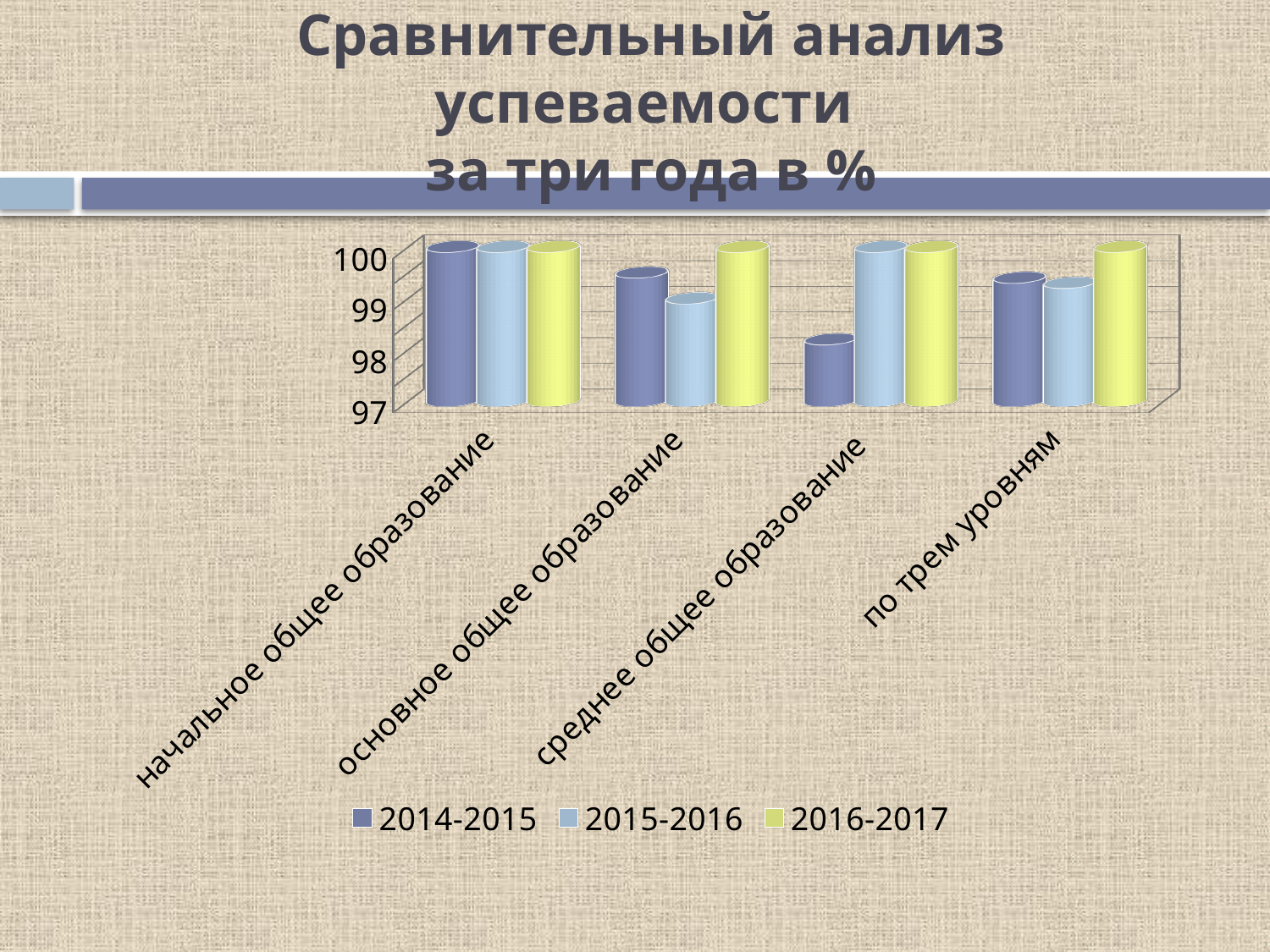
How many categories are shown on the x axis? 4 In основное общее образование, which is larger: the value for 2014-2015 or for 2015-2016? 2014-2015 Is the value for 2015-2016 in основное общее образование greater or less than 100? less In среднее общее образование, which is larger: the value for 2014-2015 or for 2015-2016? 2015-2016 How many series does the legend list? 3 Which series are listed in the legend? 2014-2015, 2015-2016, 2016-2017 In среднее общее образование, which series has the lowest value? 2014-2015 Is the value for 2014-2015 in основное общее образование greater or less than 99? greater Is the value for 2014-2015 in по трем уровням greater or less than 99? greater What kind of chart is shown on the slide? bar chart What is the title of the chart? Сравнительный анализ успеваемости за три года в %